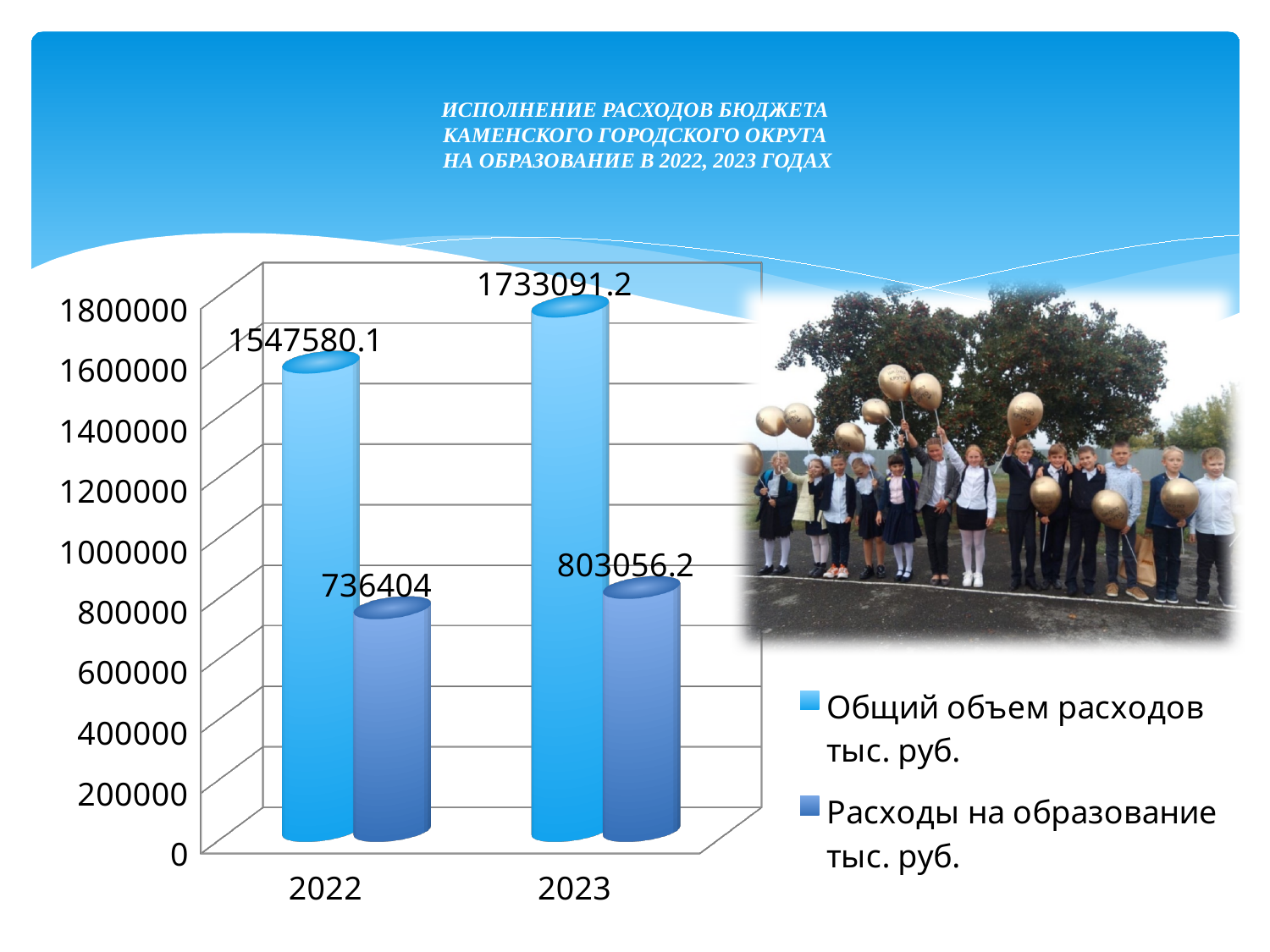
What is the value of 'Расходы на образование тыс. руб.' for 2022? 736404 What is the value of 'Общий объем расходов тыс. руб.' for 2022? 1547580.1 In which year is 'Расходы на образование тыс. руб.' lower? 2022 By how much did 'Общий объем расходов тыс. руб.' increase from 2022 to 2023? 185511.1 Which is larger in 2023: 'Общий объем расходов тыс. руб.' or 'Расходы на образование тыс. руб.'? Общий объем расходов тыс. руб. In which year is 'Общий объем расходов тыс. руб.' higher? 2023 What is the value of 'Общий объем расходов тыс. руб.' for 2023? 1733091.2 What is the value of 'Расходы на образование тыс. руб.' for 2023? 803056.2 What kind of chart is shown on the slide? Bar chart How many series does the legend list? 2 Is the value of 'Расходы на образование тыс. руб.' for 2022 greater or less than 800000? less What is the difference between 'Расходы на образование тыс. руб.' in 2023 and in 2022? 67052.2